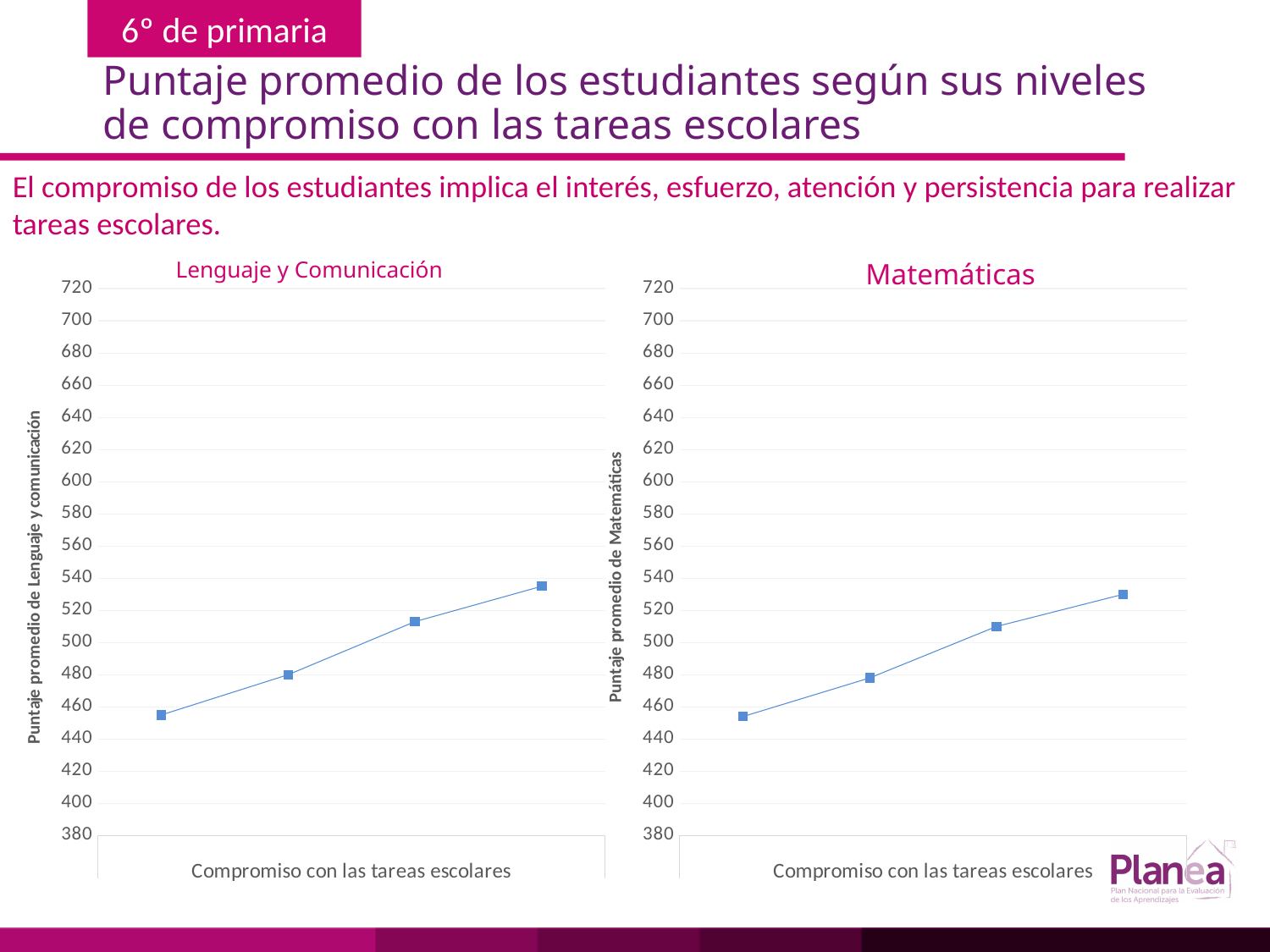
What is the y-axis title of the Lenguaje y Comunicación chart? Puntaje promedio de Lenguaje y comunicación On the Lenguaje y Comunicación chart, do the values rise or fall from left to right along the x axis? rise What is the x-axis label on the Matemáticas chart? Compromiso con las tareas escolares On the Matemáticas chart, is the value of the third point greater or less than 500? greater On the Lenguaje y Comunicación chart, is the value of the last (rightmost) point greater or less than 520? greater On the Matemáticas chart, do the values rise or fall from left to right along the x axis? rise How many data points are plotted on the Matemáticas chart? 4 What kind of chart is the Lenguaje y Comunicación chart? line chart How many data points are plotted on the Lenguaje y Comunicación chart? 4 On the Lenguaje y Comunicación chart, is the value of the first (leftmost) point greater or less than 440? greater